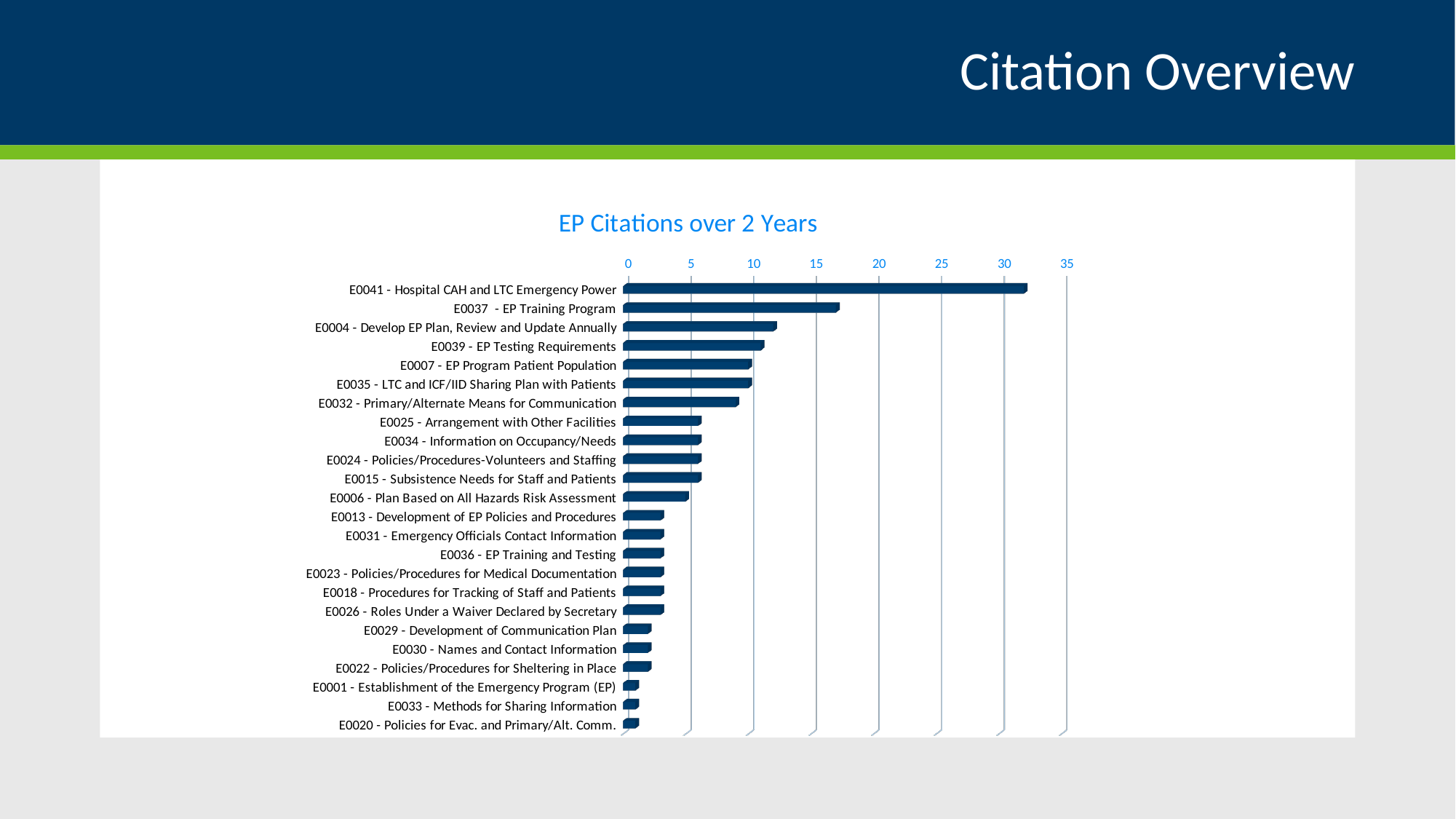
Which has more citations, E0037 - EP Training Program or E0039 - EP Testing Requirements? E0037 - EP Training Program What is the title of the chart? EP Citations over 2 Years What kind of chart is shown on the slide? bar chart What is the highest value shown on the horizontal axis? 35 Is the value for E0037 - EP Training Program greater or less than 15? greater How many categories are plotted in the chart? 24 Which has more citations, E0006 - Plan Based on All Hazards Risk Assessment or E0029 - Development of Communication Plan? E0006 - Plan Based on All Hazards Risk Assessment Is the value for E0013 - Development of EP Policies and Procedures greater or less than 5? less Which category has the highest number of citations? E0041 - Hospital CAH and LTC Emergency Power Is the value for E0004 - Develop EP Plan, Review and Update Annually greater or less than 10? greater